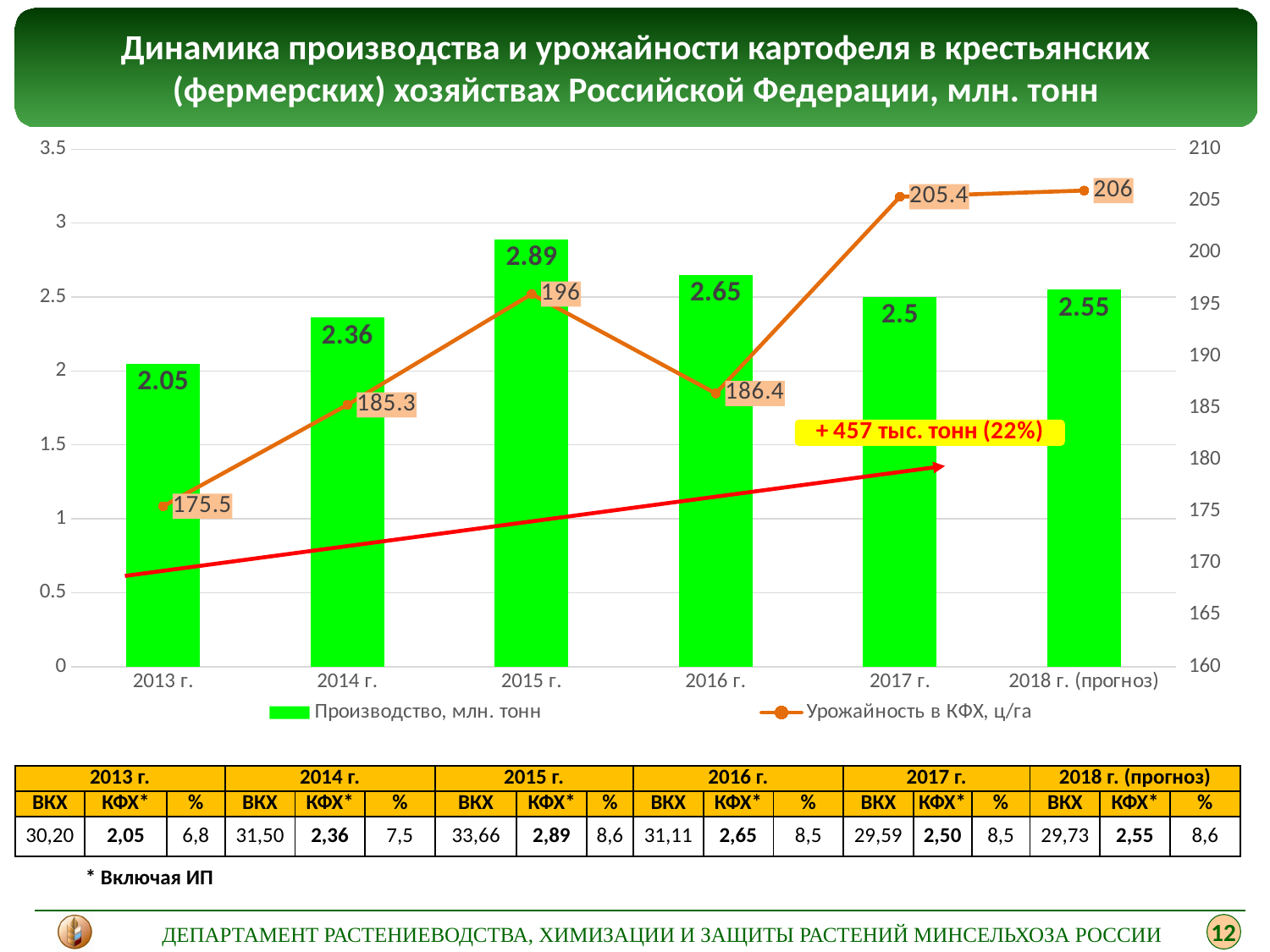
What text is shown in the yellow callout on the chart? + 457 тыс. тонн (22%) What is the yield (Урожайность в КФХ, ц/га) for 2013 г.? 175.5 What is the difference in production between 2015 г. and 2013 г.? 0.84 How many series does the chart legend list? 2 What kind of chart is used to show production (Производство, млн. тонн)? bar chart Which year has the highest production (Производство, млн. тонн)? 2015 г. What is the production value (Производство, млн. тонн) for 2015 г.? 2.89 Which year has the lowest yield (Урожайность в КФХ, ц/га)? 2013 г. Is the yield for 2016 г. greater or less than 190? less What is the yield (Урожайность в КФХ, ц/га) for 2017 г.? 205.4 Which is larger: the production for 2016 г. or for 2018 г. (прогноз)? 2016 г. How many years are shown on the x axis of the chart? 6